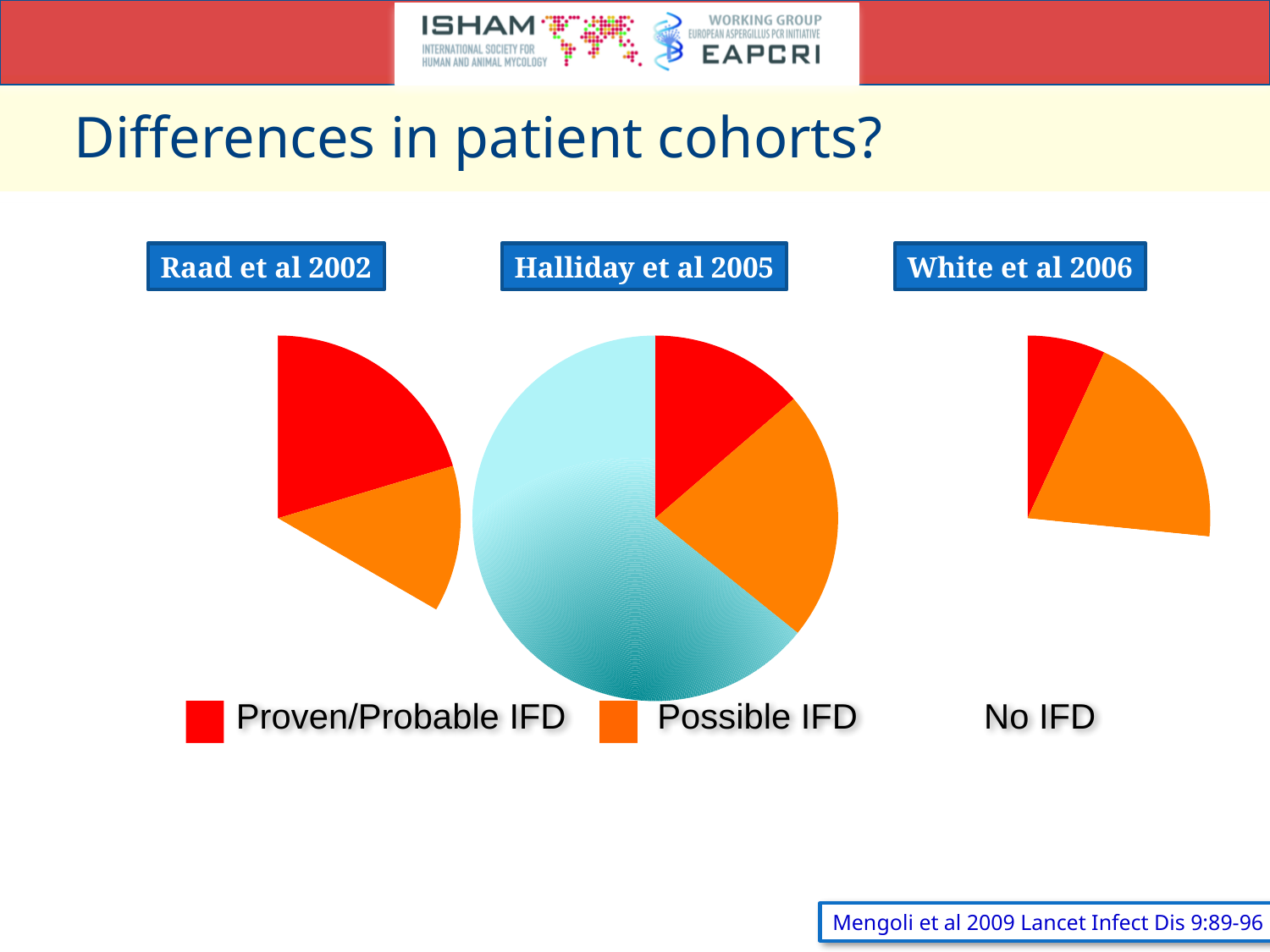
What is the title of the slide containing the pie charts? Differences in patient cohorts? What colour represents Possible IFD in the legend? Orange In the Halliday et al 2005 pie chart, which slice is larger: Possible IFD or Proven/Probable IFD? Possible IFD In the Raad et al 2002 pie chart, which slice is larger: Proven/Probable IFD or Possible IFD? Proven/Probable IFD What kind of chart is used for the Halliday et al 2005 data? Pie chart How many pie charts are shown on the slide? 3 In the White et al 2006 pie chart, which slice is larger: Proven/Probable IFD or Possible IFD? Possible IFD In the Halliday et al 2005 pie chart, which category has the smallest slice? Proven/Probable IFD In the Halliday et al 2005 pie chart, which category has the largest slice? No IFD Which of the three pie charts shows a No IFD slice? Halliday et al 2005 How many categories does the legend list? 3